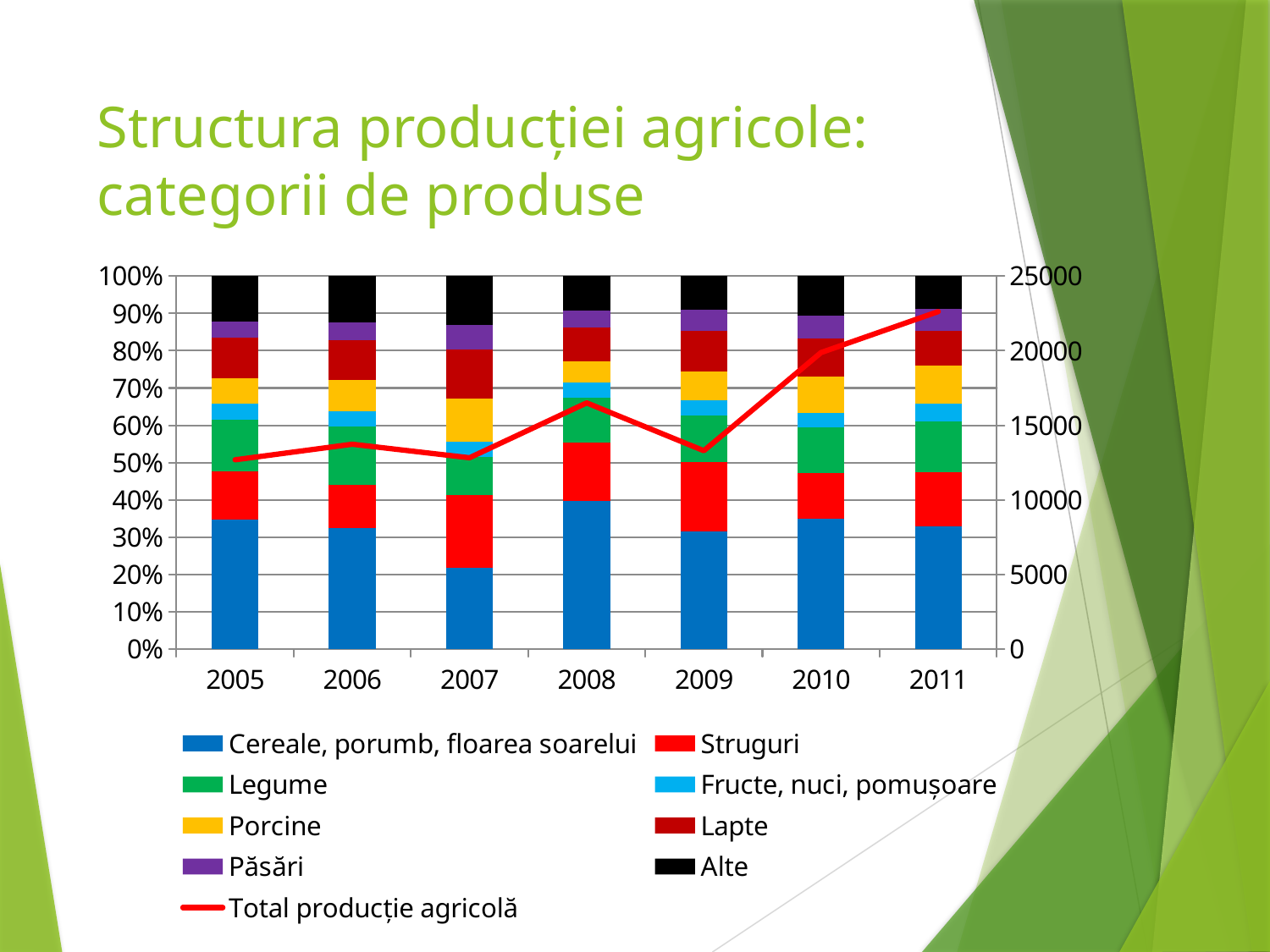
Is the value of Total producție agricolă in 2008 greater or less than 15000? greater Which year has the larger Total producție agricolă, 2008 or 2009? 2008 Does Total producție agricolă rise or fall overall from 2005 to 2011? rise Which year has the highest value for Total producție agricolă? 2011 What is the title of the slide containing the chart? Structura producției agricole: categorii de produse How many years are shown on the x axis of the chart? 7 In which year is the share of Cereale, porumb, floarea soarelui the lowest? 2007 Is the share of Cereale, porumb, floarea soarelui in 2007 greater or less than 30%? less Is the value of Total producție agricolă in 2005 greater or less than 15000? less How many series does the chart legend list? 9 What kind of chart is shown on the slide? A stacked bar chart with a line series